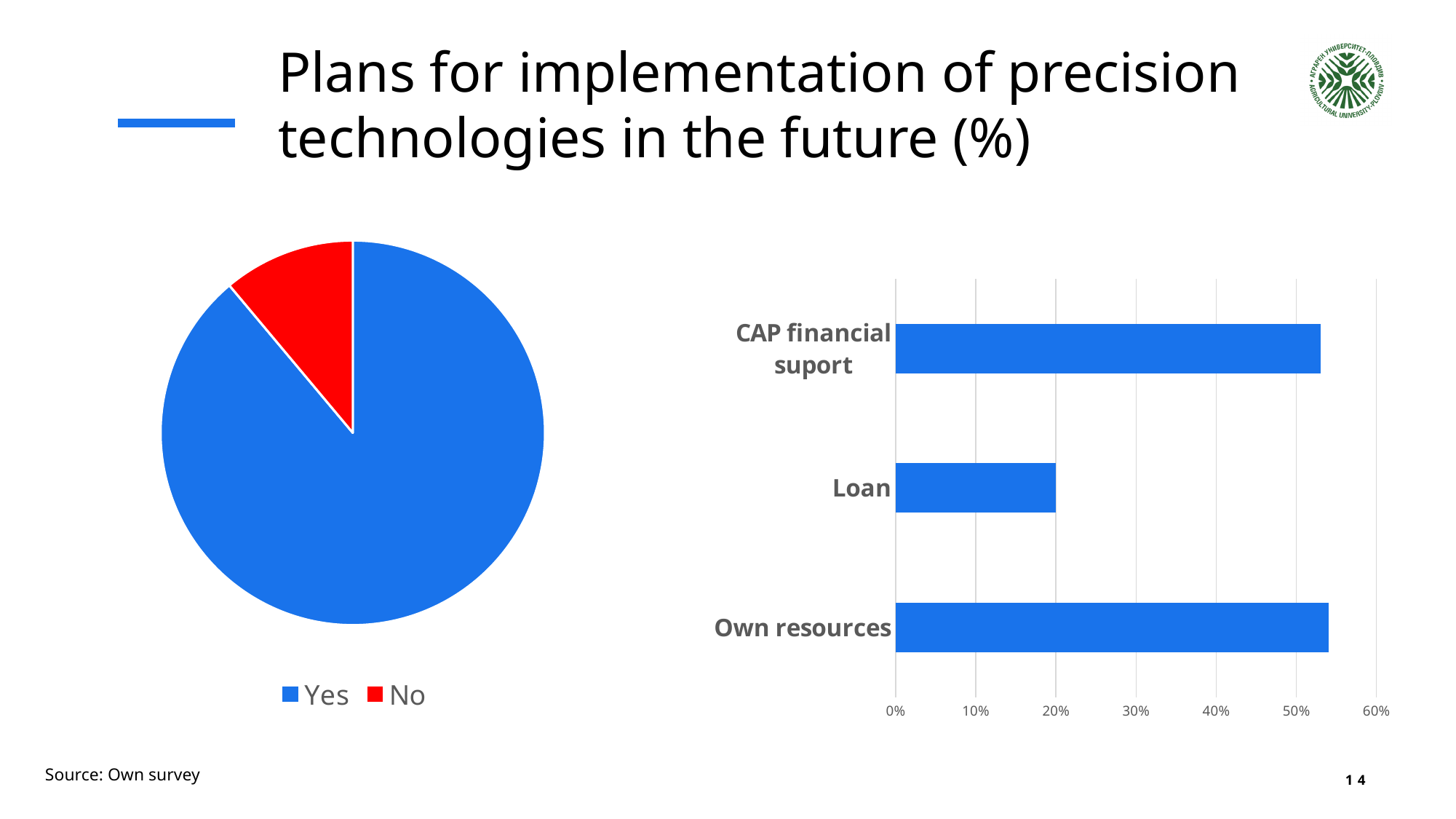
In the bar chart on the right, how many categories are shown? 3 In the pie chart on the left, how many entries does the legend list? 2 In the bar chart on the right, what is the value for Loan? 20% In the bar chart on the right, is the value for Loan greater or less than 30%? less In the pie chart on the left, what colour is the No slice? red In the pie chart on the left, which slice is larger: Yes or No? Yes In the bar chart on the right, is the value for CAP financial suport greater or less than 50%? greater In the bar chart on the right, which is larger: Own resources or Loan? Own resources In the bar chart on the right, is the value for Own resources greater or less than 40%? greater In the bar chart on the right, which category has the lowest value? Loan What kind of chart is the chart on the left of the slide? pie chart What kind of chart is the chart on the right of the slide? bar chart